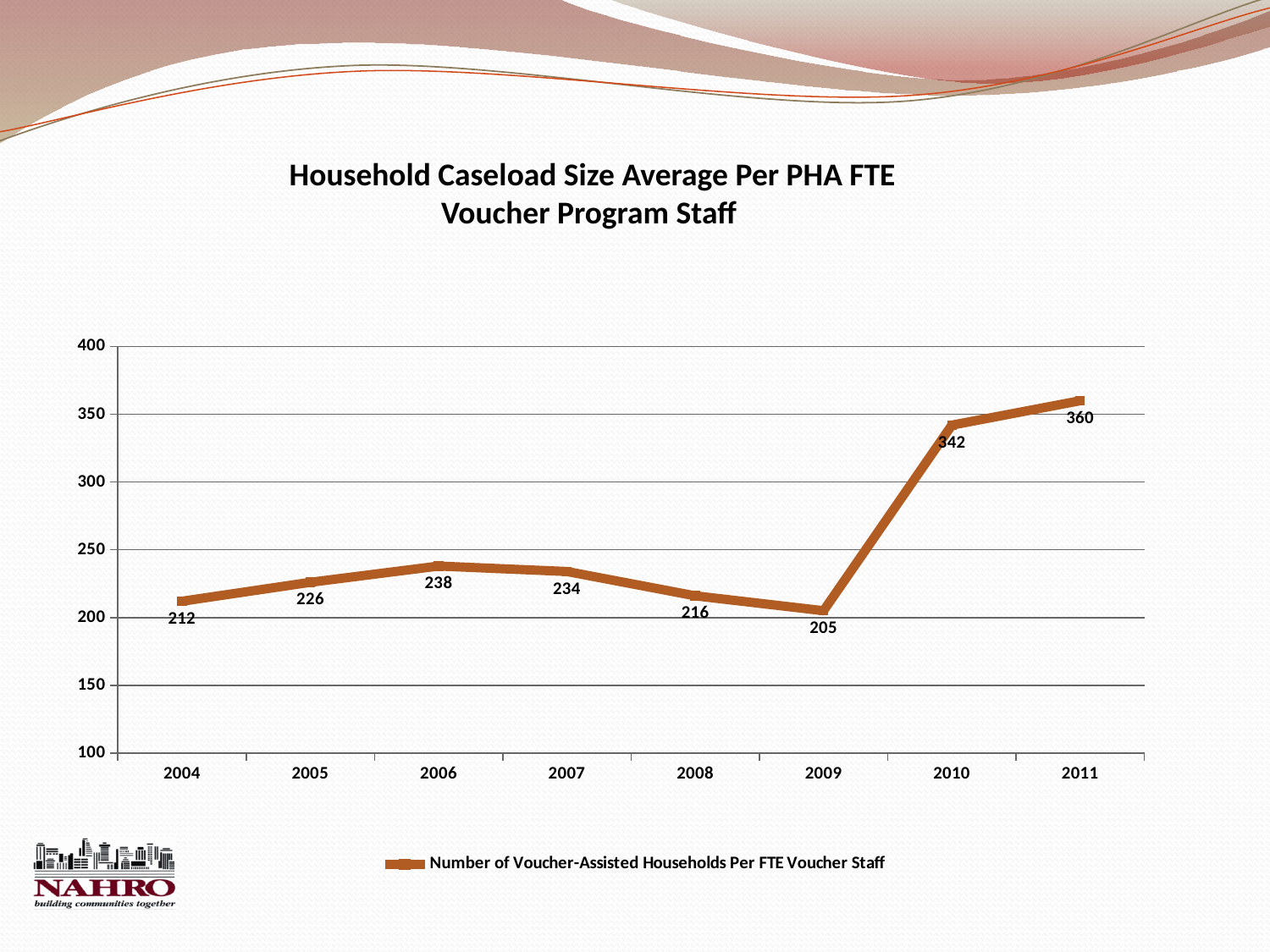
What is the legend entry for the plotted series? Number of Voucher-Assisted Households Per FTE Voucher Staff What kind of chart is shown? line chart Is the value for 2010 greater or less than 300? greater Which year has the lowest value? 2009 What is the difference between the values for 2010 and 2009? 137 Which year has the highest value? 2011 What is the value for 2004? 212 What is the value for 2011? 360 How many years are plotted on the x axis? 8 How many series does the legend list? 1 What is the value for 2009? 205 Which is larger, the value for 2006 or the value for 2007? 2006